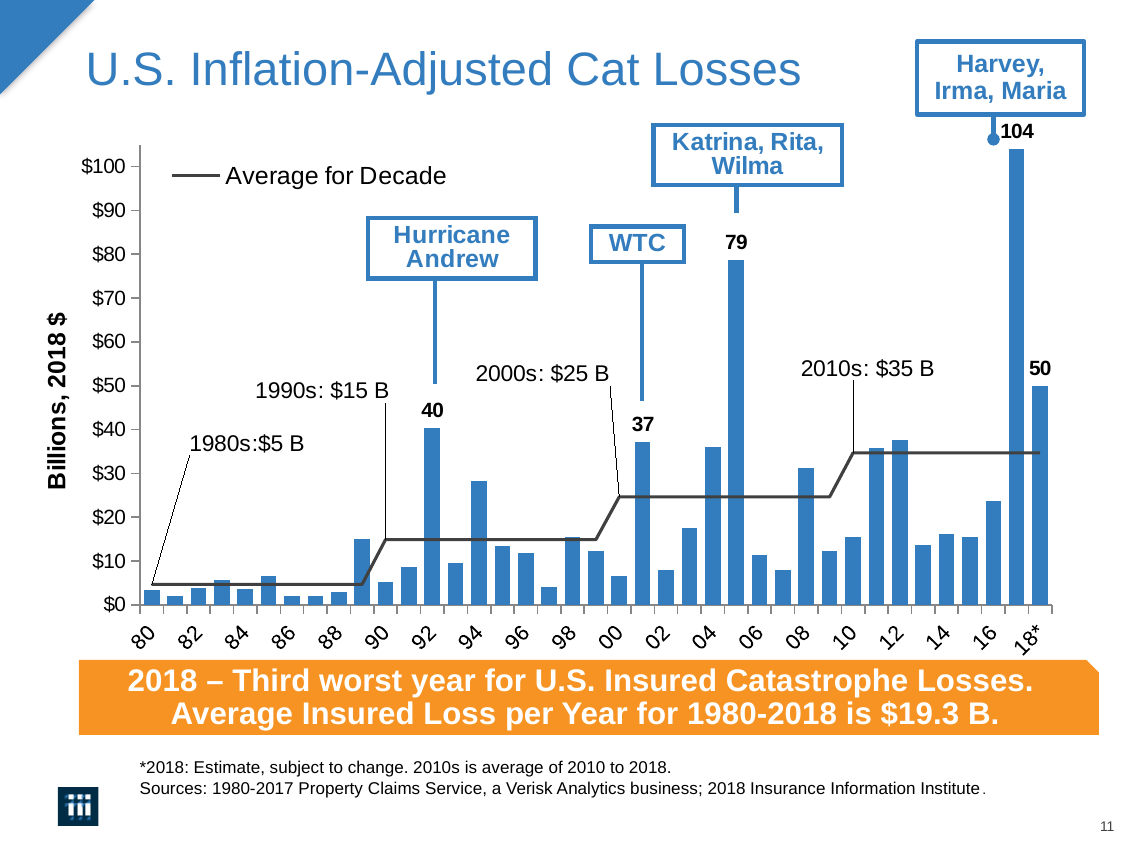
What is the value for 2001 (WTC)? 37 Which is larger, the value for 2005 or the value for 2018? 2005 What is the difference between the 2017 value and the 2005 value? 25 What is the value for 2017 (Harvey, Irma, Maria)? 104 What is the difference between the 2018 value and the 1992 value? 10 Is the value for 1994 greater or less than $30? less What is the value for 1992 (Hurricane Andrew)? 40 What is the average for the 2010s decade shown on the chart? $35 B What kind of chart is this? combination bar and line chart Do the decade averages rise or fall from the 1980s to the 2010s? rise What is the value for 2005 (Katrina, Rita, Wilma)? 79 Which year has the highest cat losses? 2017